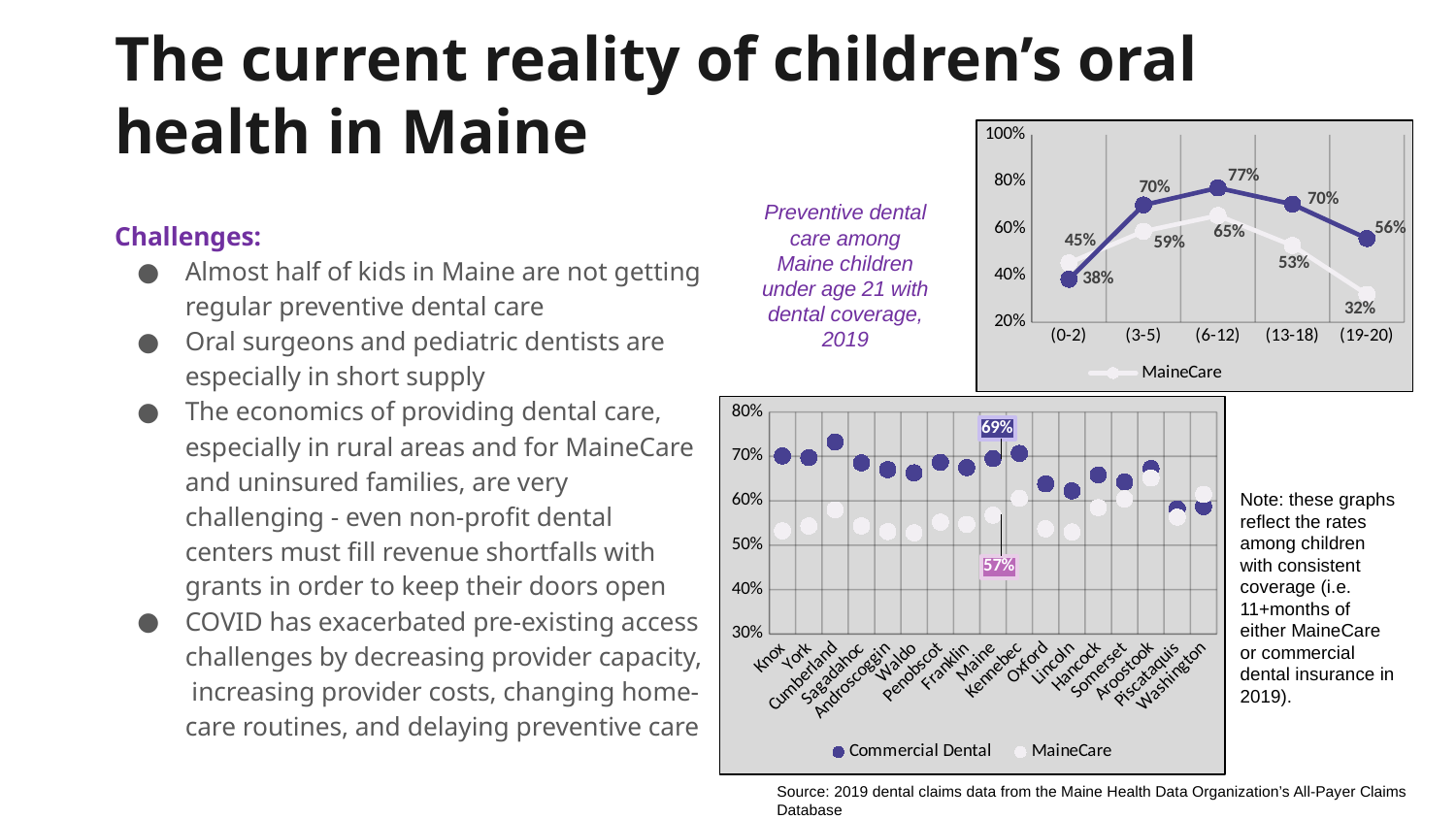
In the top chart, what is the MaineCare value for the (19-20) age group? 32% In the top chart (Preventive dental care among Maine children under age 21 with dental coverage, 2019), what is the MaineCare value for the (6-12) age group? 65% How many series does the legend of the bottom chart list? 2 In the bottom chart (by county), what is the Commercial Dental value for Maine? 69% How many age groups are shown on the x axis of the top chart? 5 In the bottom chart, is the Commercial Dental value for Cumberland greater or less than 70%? greater In the top chart, what is the difference between the MaineCare values for the (6-12) and (19-20) age groups? 33 percentage points In the bottom chart, what is the difference between the Commercial Dental and MaineCare values for Maine? 12 percentage points In the top chart, which age group has the highest MaineCare value? (6-12) In the top chart, which age group has the lowest MaineCare value? (19-20) In the bottom chart, what is the MaineCare value for Maine? 57% In the top chart, which is larger: the MaineCare value for (0-2) or for (3-5)? (3-5)